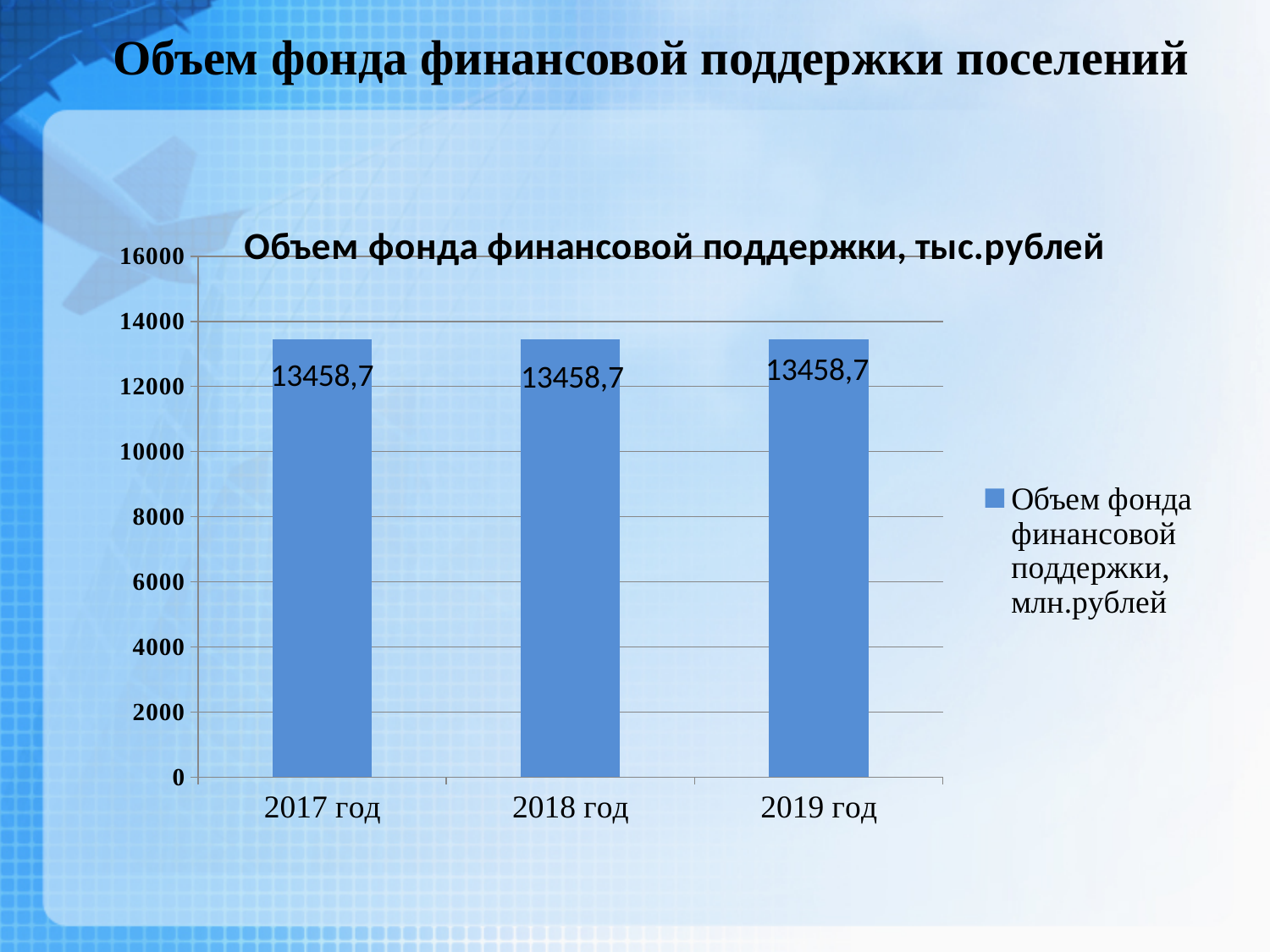
How many series does the legend list? 1 Is the value for 2019 год greater or less than 14000? less What kind of chart is shown? bar chart Do the values rise, fall or stay the same from 2017 год to 2019 год? stay the same What is the value for 2017 год? 13458,7 What is the difference between the values for 2017 год and 2019 год? 0 What is the legend entry for the series? Объем фонда финансовой поддержки, млн.рублей What is the title of the chart? Объем фонда финансовой поддержки, тыс.рублей How many categories are shown on the x axis? 3 Is the value for 2018 год greater or less than 12000? greater What is the value for 2019 год? 13458,7 What is the value for 2018 год? 13458,7